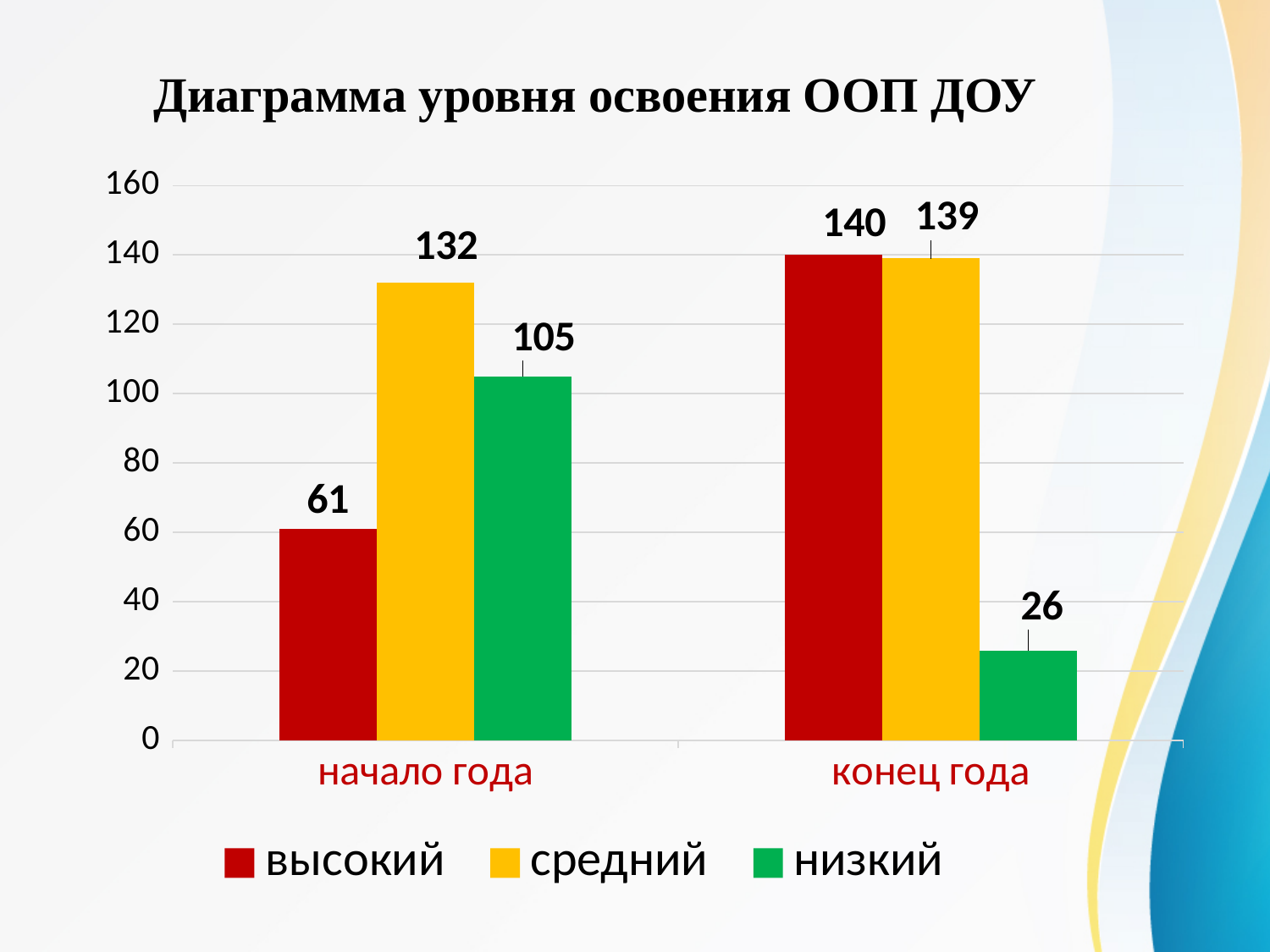
What kind of chart is shown on the slide? bar chart What is the title of the chart? Диаграмма уровня освоения ООП ДОУ What is the difference between the высокий values at конец года and начало года? 79 How many series does the legend list? 3 What is the value for средний at начало года? 132 Is the value for средний at конец года greater or less than 120? greater Which is larger: низкий at начало года or низкий at конец года? низкий at начало года What is the value for низкий at конец года? 26 Which series has the highest value at конец года? высокий Which series has the lowest value at начало года? высокий How many categories are shown on the x axis? 2 What is the value for высокий at начало года? 61